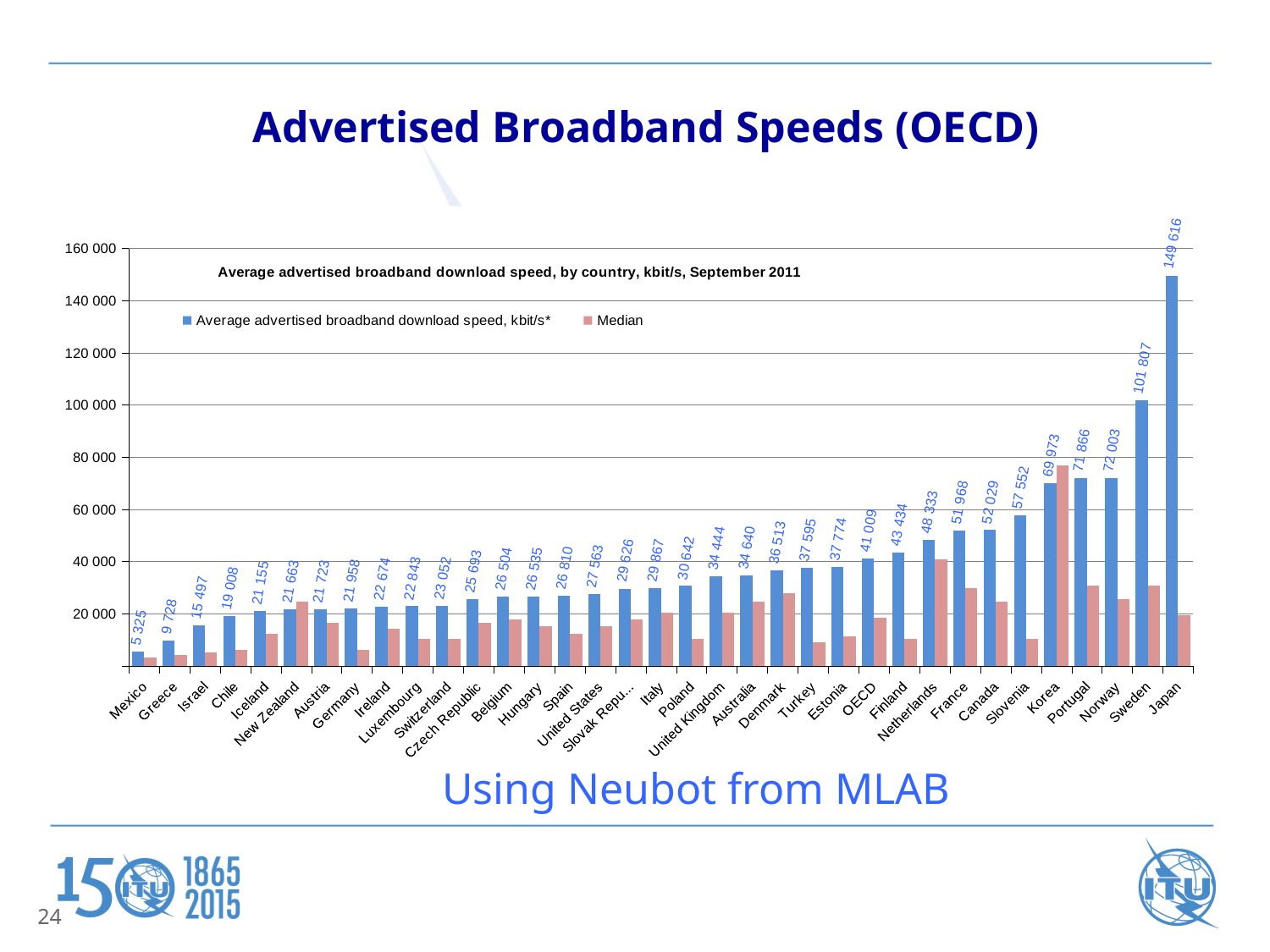
Is the Median value for Korea greater or less than 60 000? greater What is the average advertised broadband download speed for Korea? 69 973 What is the average advertised broadband download speed for the OECD? 41 009 How many series does the chart legend list? 2 Which country has the highest average advertised broadband download speed? Japan Which has a higher average advertised broadband download speed, Canada or Finland? Canada Do the average advertised broadband download speeds rise or fall from left to right along the x axis? rise How many countries/categories are shown on the x axis of the chart? 35 What is the average advertised broadband download speed for Sweden? 101 807 What is the difference between the average advertised broadband download speeds of Japan and Sweden? 47 809 Which country has the lowest average advertised broadband download speed? Mexico What kind of chart is shown on the slide? bar chart